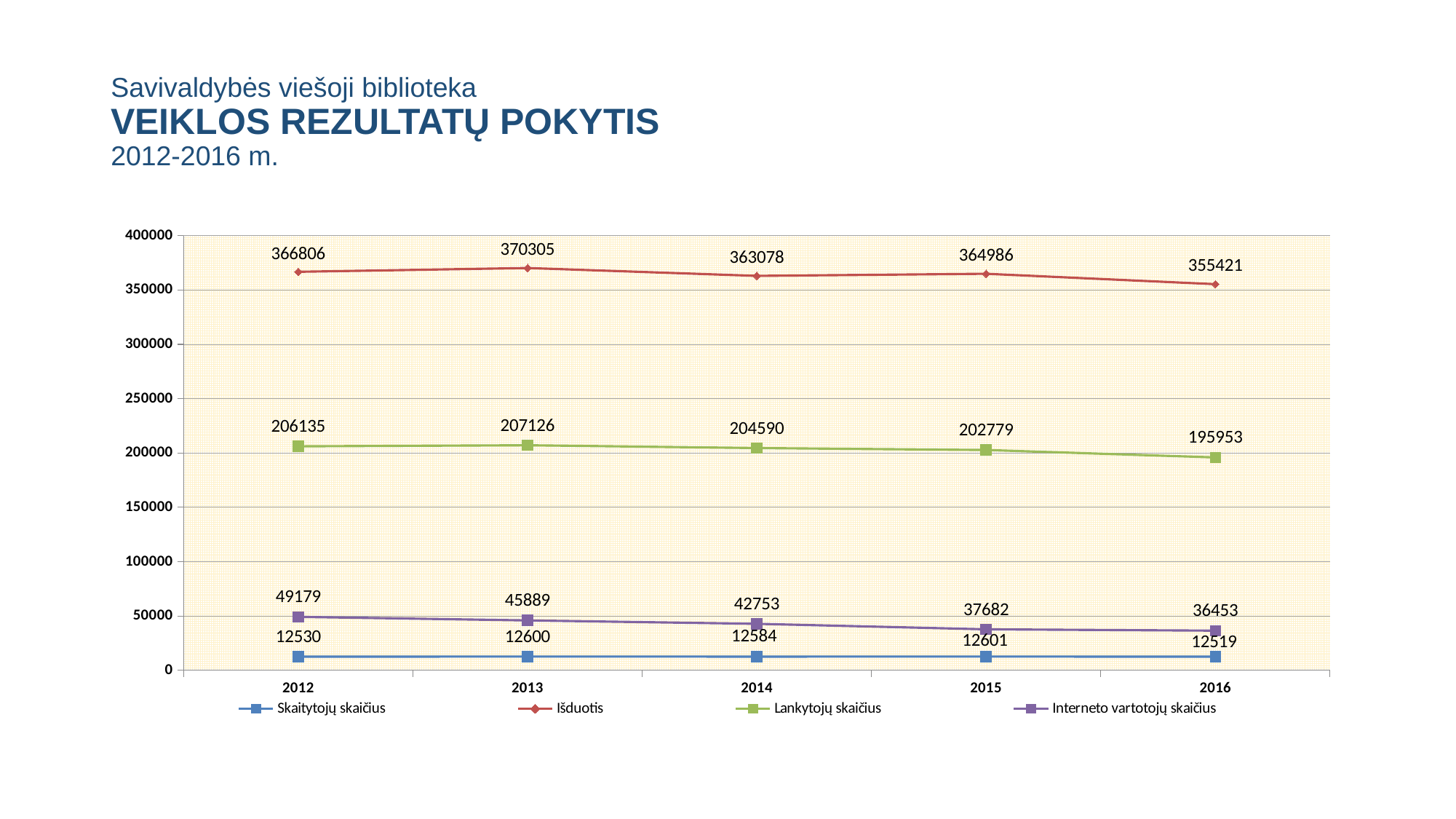
How many series does the legend list? 4 In which year is Išduotis highest? 2013 Which is larger: Lankytojų skaičius in 2013 or in 2015? 2013 What is the difference between Išduotis in 2012 and in 2016? 11385 What is the value of Lankytojų skaičius in 2016? 195953 In which year is Interneto vartotojų skaičius lowest? 2016 What is the value of Interneto vartotojų skaičius in 2014? 42753 How many years are shown on the x axis? 5 What is the value of Skaitytojų skaičius in 2015? 12601 What is the value of Išduotis in 2013? 370305 What kind of chart is shown on the slide? line chart Is the value of Išduotis in 2016 greater or less than 350000? greater